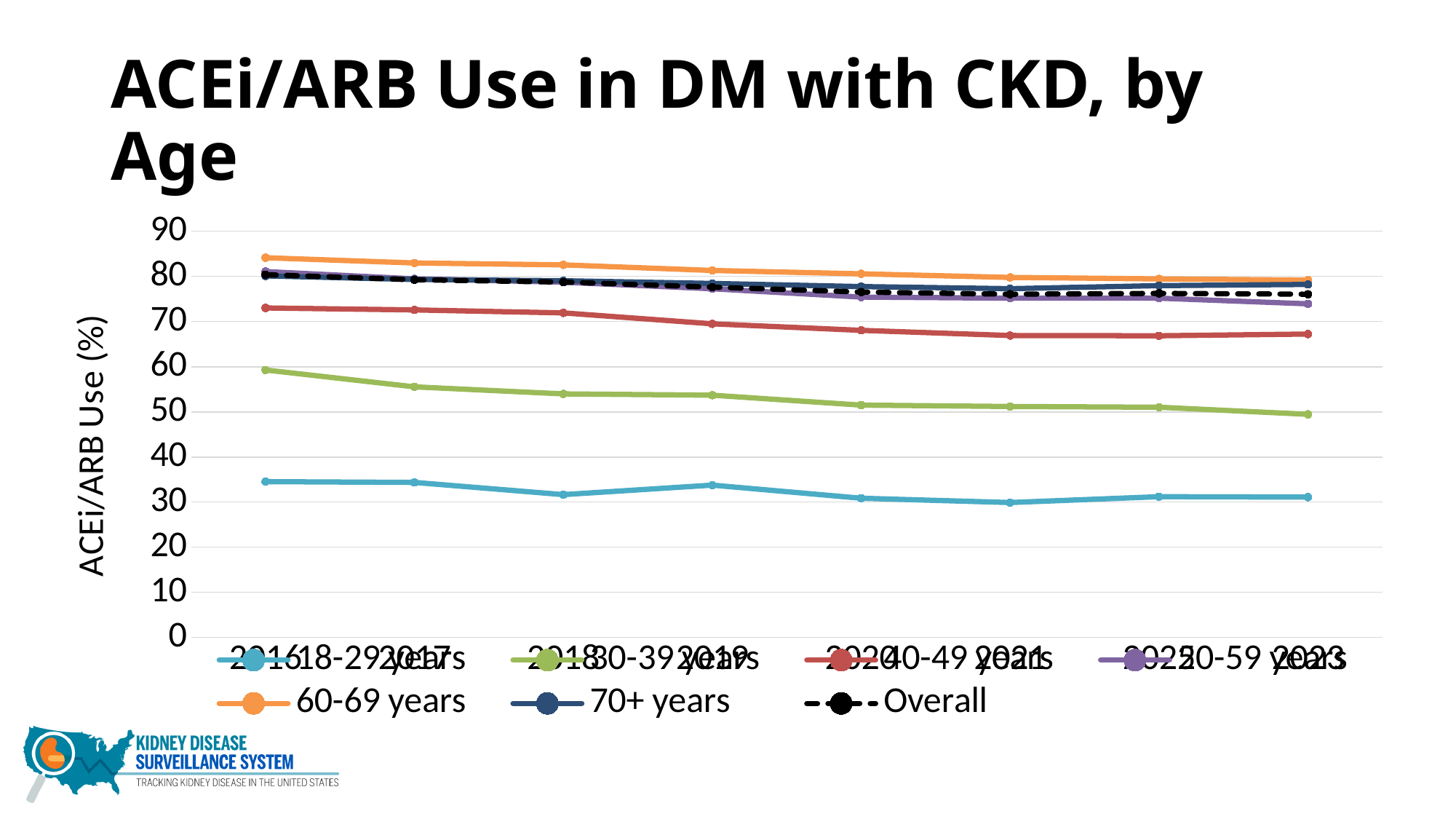
Which series is drawn with a dashed line? Overall Is the value for 40-49 years in 2023 greater or less than 70? less In 2016, which is larger: the value for 60-69 years or the value for 40-49 years? 60-69 years Is the value for 60-69 years in 2016 greater or less than 80? greater What is the label of the vertical axis? ACEi/ARB Use (%) How many series does the legend list? 7 What kind of chart is shown on the slide? line chart Is the value for 30-39 years in 2016 greater or less than 50? greater Which age group has the highest ACEi/ARB use across the years shown? 60-69 years Does the 30-39 years line rise or fall from 2016 to 2023? fall Which age group has the lowest ACEi/ARB use across the years shown? 18-29 years